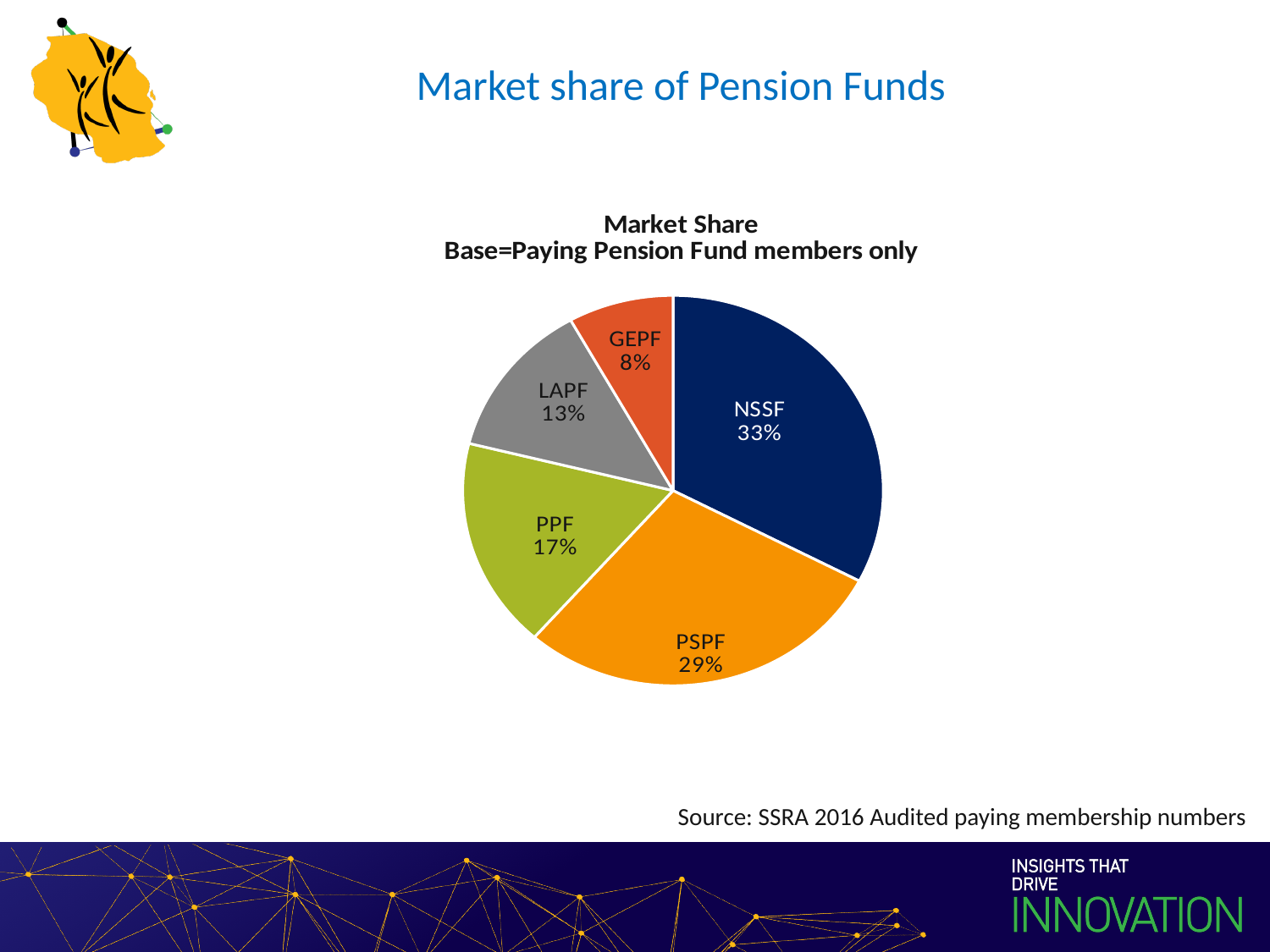
What is the title of the chart? Market Share Base=Paying Pension Fund members only What type of chart is shown on the slide? pie chart What is the market share of LAPF? 13% Which pension fund has the largest market share? NSSF What is the market share of PPF? 17% Which has a larger market share, PPF or LAPF? PPF What is the market share of PSPF? 29% What is the difference in market share between NSSF and PSPF? 4% What is the market share of GEPF? 8% How many pension funds are shown in the pie chart? 5 Which pension fund has the smallest market share? GEPF What is the market share of NSSF? 33%